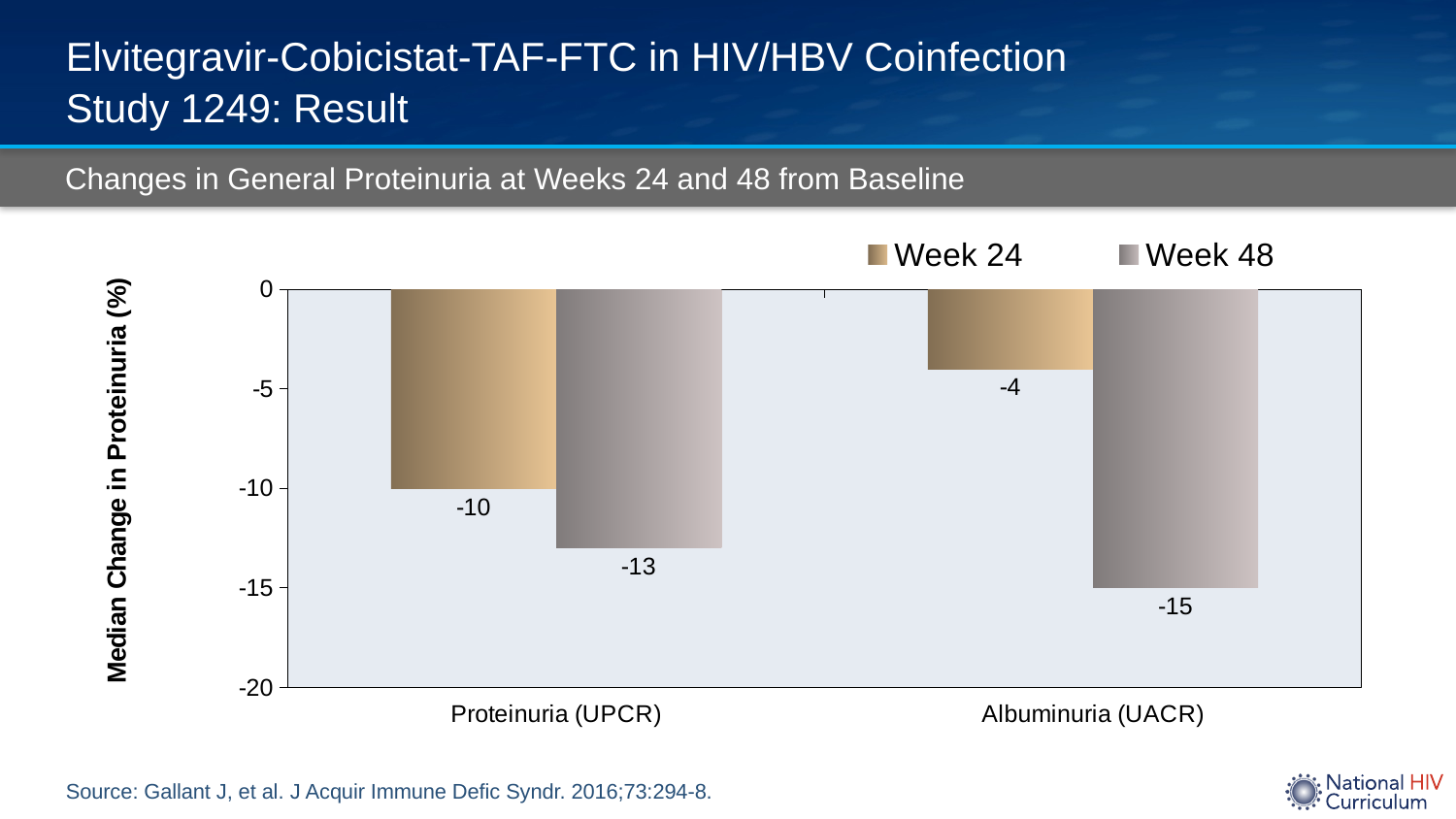
What is the Week 48 value for Albuminuria (UACR)? -15 What is the difference between the Week 24 and Week 48 values for Albuminuria (UACR)? 11 What is the Week 24 value for Proteinuria (UPCR)? -10 How many series does the legend list? 2 What kind of chart is shown on the slide? bar chart What is the Week 24 value for Albuminuria (UACR)? -4 Which category has the highest Week 24 value? Albuminuria (UACR) What is the difference between the Week 24 and Week 48 values for Proteinuria (UPCR)? 3 Which category has the lowest Week 48 value? Albuminuria (UACR) What is the Week 48 value for Proteinuria (UPCR)? -13 How many categories are shown on the x axis? 2 Is the Week 24 value for Proteinuria (UPCR) larger or smaller than the Week 24 value for Albuminuria (UACR)? smaller